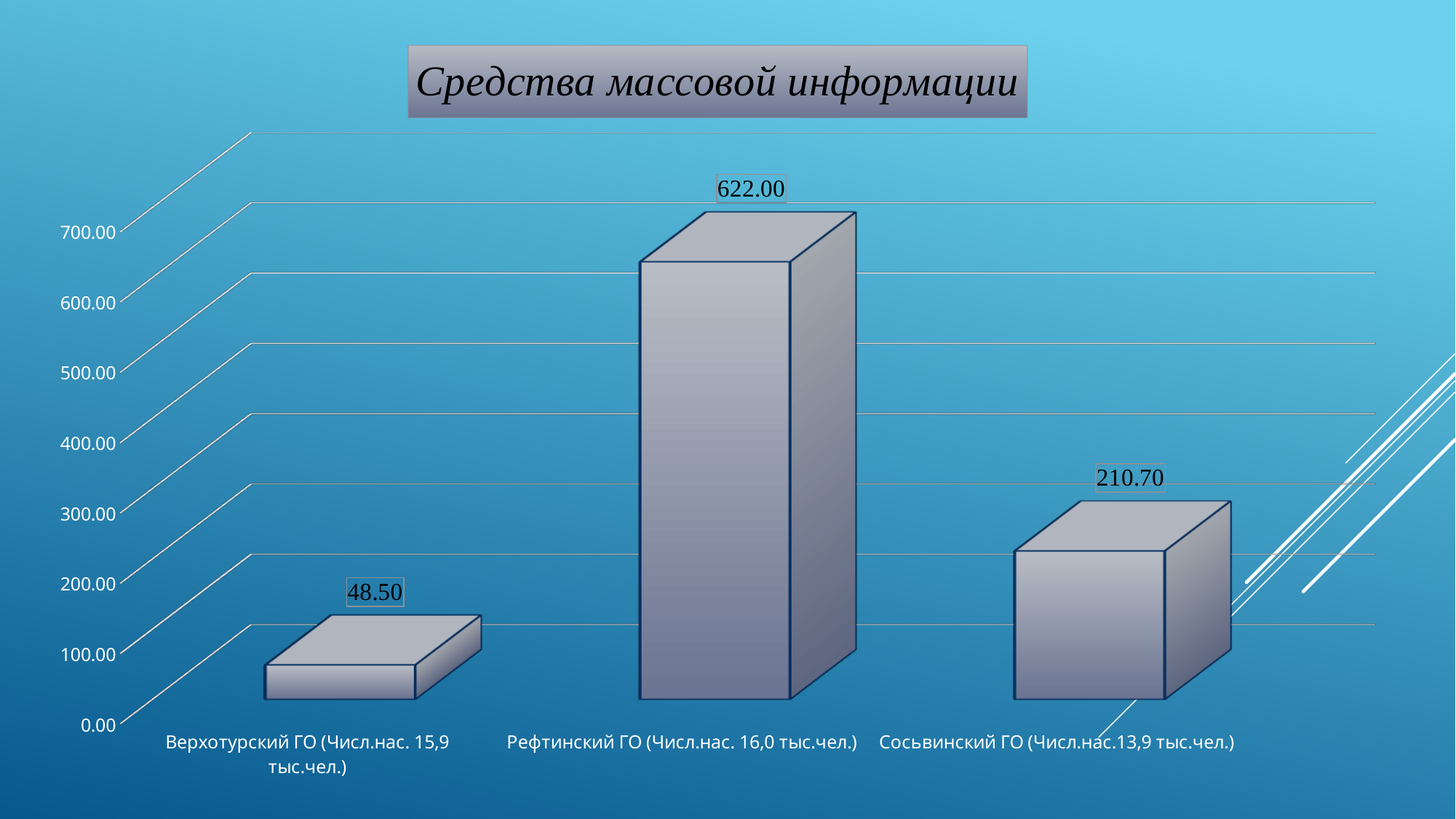
Which is larger, the value for Сосьвинский ГО or the value for Верхотурский ГО? Сосьвинский ГО What is the difference between the values for Рефтинский ГО and Сосьвинский ГО? 411.30 Is the value for Рефтинский ГО greater or less than 600.00? greater What is the title of the chart? Средства массовой информации Which category has the highest value? Рефтинский ГО What kind of chart is shown on the slide? bar chart What is the difference between the values for Сосьвинский ГО and Верхотурский ГО? 162.20 What is the value for Сосьвинский ГО? 210.70 What is the value for Рефтинский ГО? 622.00 How many categories are shown in the chart? 3 What is the value for Верхотурский ГО? 48.50 Which category has the lowest value? Верхотурский ГО